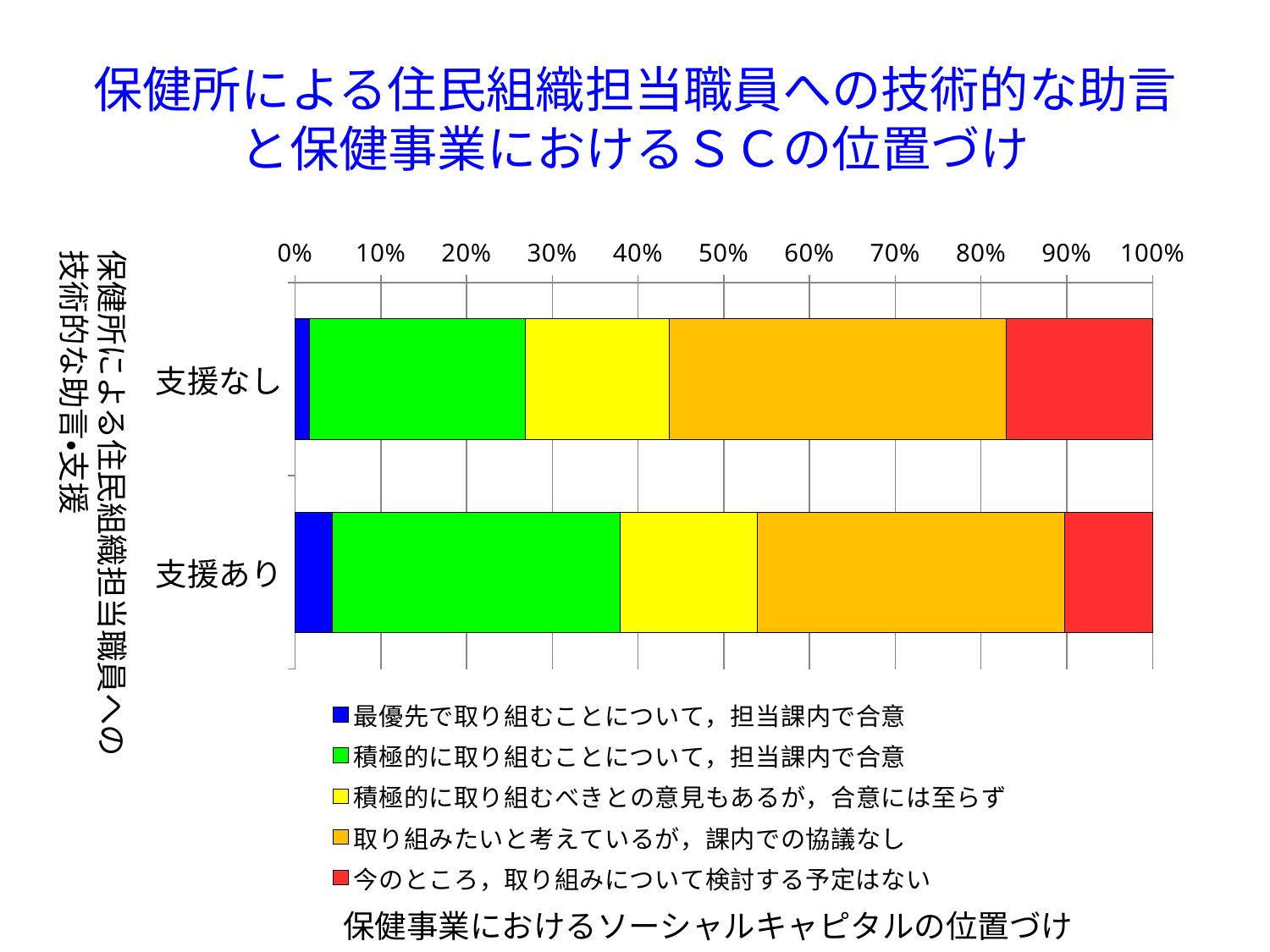
How many series does the legend list? 5 Which bar has the larger blue (最優先で取り組むことについて，担当課内で合意) segment, 支援なし or 支援あり? 支援あり Which series occupies the largest share of the 支援なし bar? 取り組みたいと考えているが，課内での協議なし Which series occupies the smallest share of the 支援あり bar? 最優先で取り組むことについて，担当課内で合意 What is the label shown below the legend as the horizontal axis title? 保健事業におけるソーシャルキャピタルの位置づけ Is the red segment of the 支援あり bar greater or less than 20%? less Which bar has the larger red (今のところ，取り組みについて検討する予定はない) segment, 支援なし or 支援あり? 支援なし Is the orange segment of the 支援なし bar greater or less than 30%? greater What kind of chart is shown on the slide? stacked bar chart Is the green segment of the 支援あり bar greater or less than 30%? greater Which bar has the larger green (積極的に取り組むことについて，担当課内で合意) segment, 支援なし or 支援あり? 支援あり How many categories (bars) does the chart show? 2